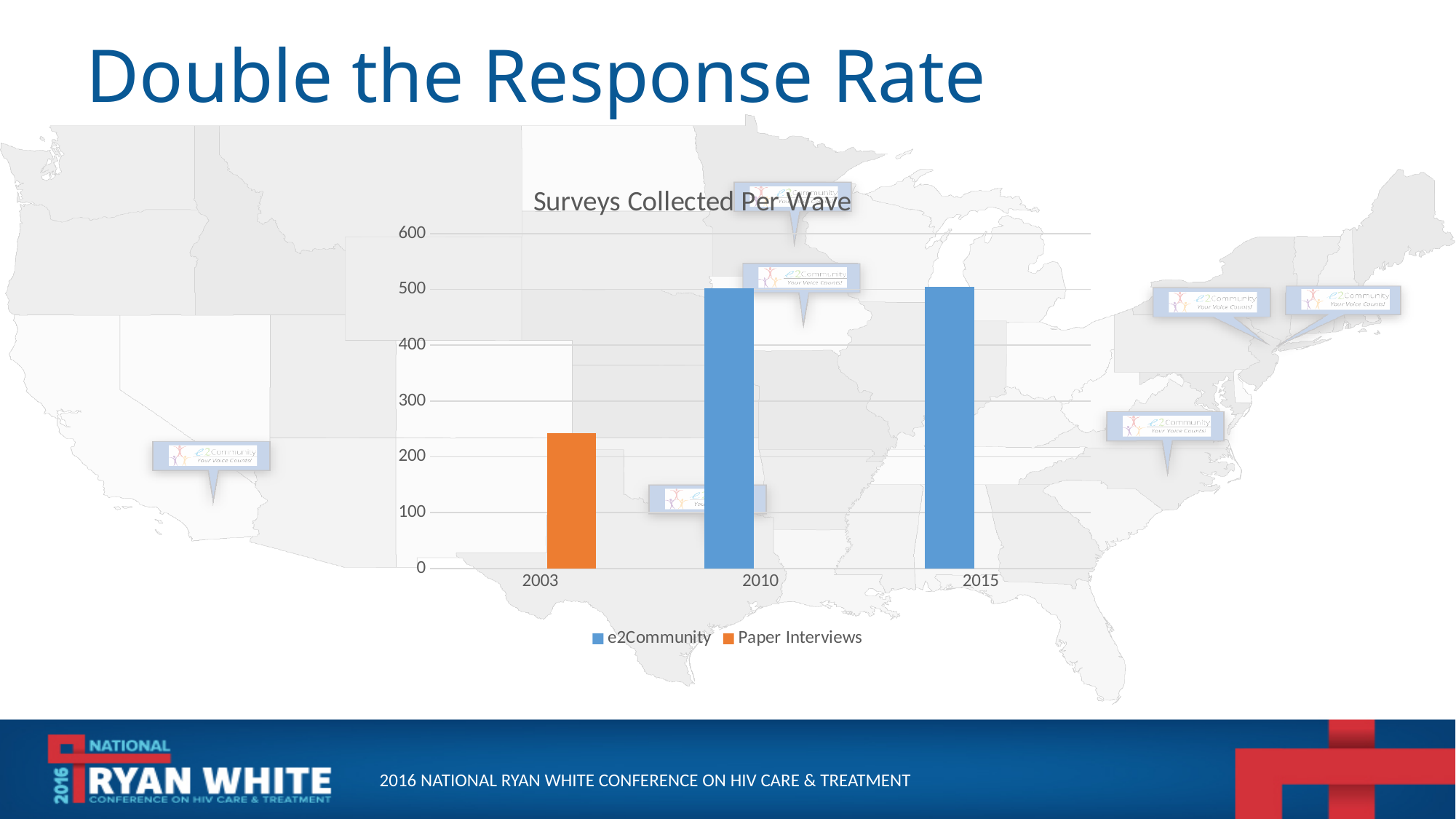
Is the value for 2003 greater or less than 200? greater What is the title of the chart? Surveys Collected Per Wave Is the value for 2015 greater or less than 400? greater Is the value for 2003 greater or less than 300? less Which series does the orange bar represent? Paper Interviews Which year had more surveys collected, 2003 or 2010? 2010 How many series does the chart's legend list? 2 Do the values rise or fall from 2003 to 2015? rise How many years (categories) are shown on the x axis of the chart? 3 What kind of chart is shown on the slide? bar chart Which year has the lowest number of surveys collected? 2003